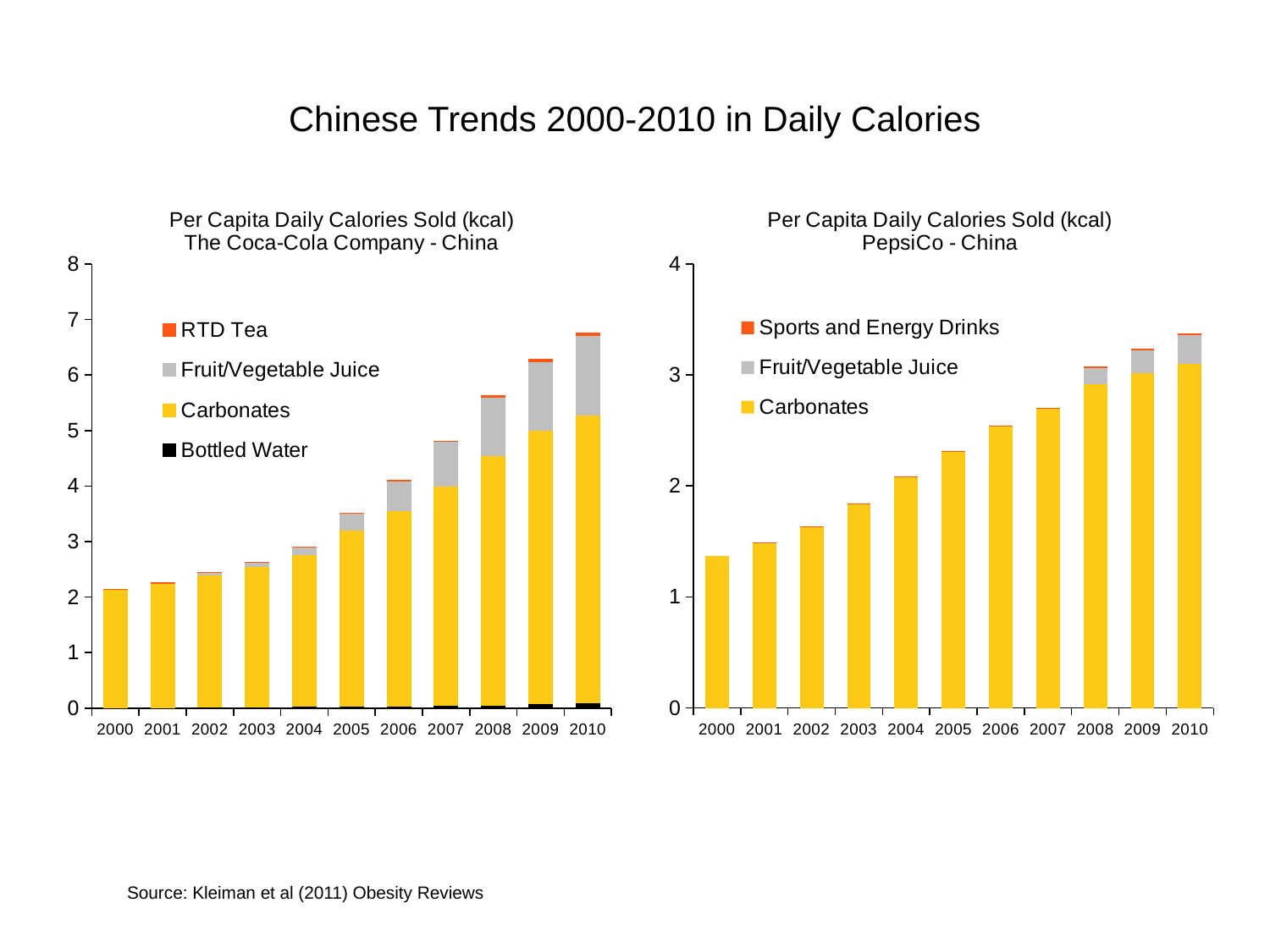
In the PepsiCo - China chart, which year has the lowest total per capita daily calories sold? 2000 In the Coca-Cola Company - China chart, is the total value for 2010 greater or less than 6? greater In the PepsiCo - China chart, is the total value for 2000 greater or less than 2? less In the PepsiCo - China chart, is the total value for 2010 greater or less than 3? greater How many series does the legend of the PepsiCo - China chart list? 3 How many series does the legend of the Coca-Cola Company - China chart list? 4 In the Coca-Cola Company - China chart, which series is shown in black? Bottled Water How many years are shown on the x axis of the PepsiCo - China chart? 11 In the Coca-Cola Company - China chart, which year has the highest total per capita daily calories sold? 2010 What type of chart is the Coca-Cola Company - China chart? stacked bar chart In the PepsiCo - China chart, do the total per capita daily calories sold rise or fall from 2000 to 2010? rise